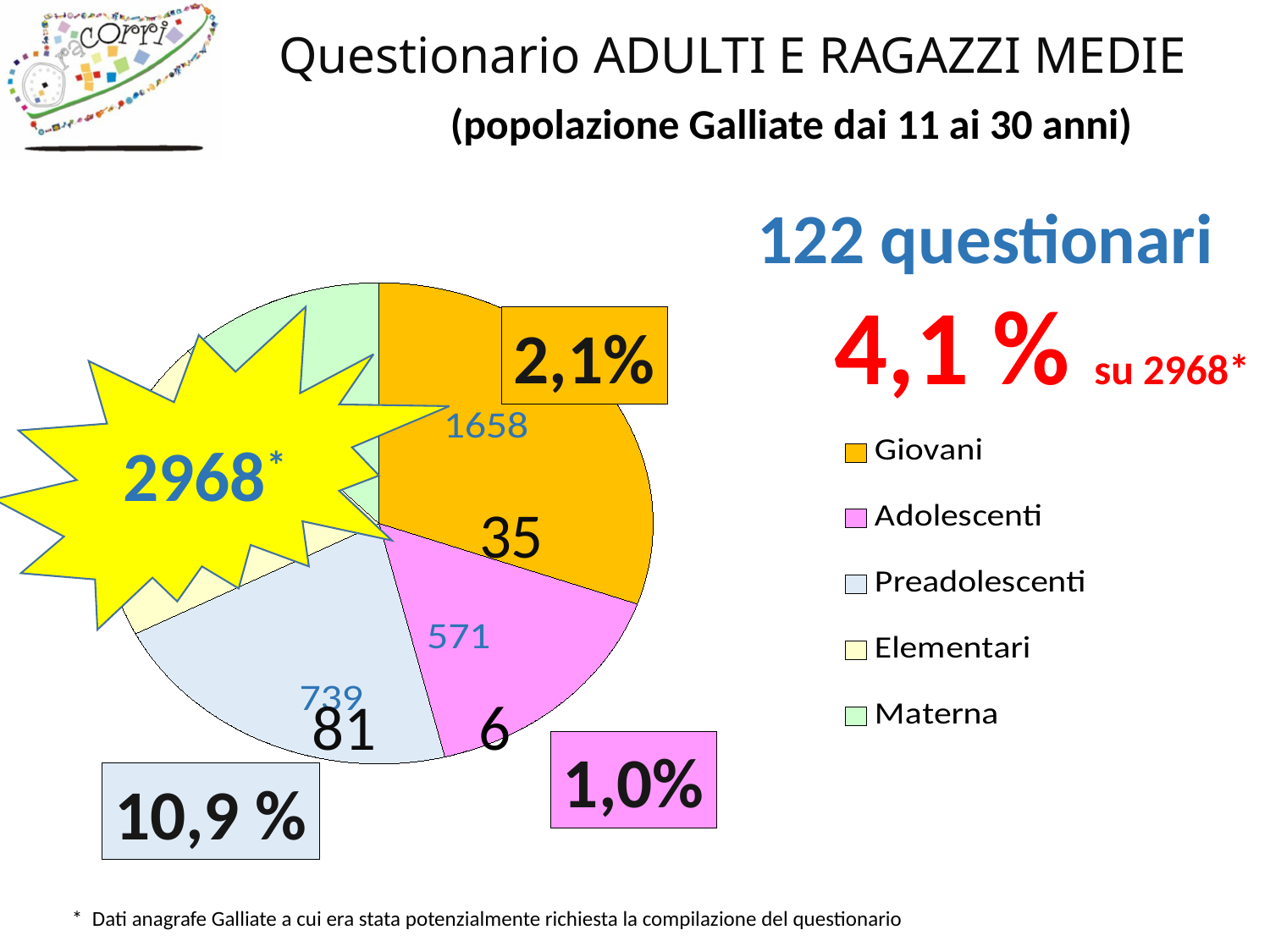
What percentage is shown in the box next to the Preadolescenti slice of the pie chart? 10,9 % What is the difference between the Giovani value and the Adolescenti value in the pie chart? 1087 What is the value shown for the Giovani slice of the pie chart? 1658 What is the value shown for the Preadolescenti slice of the pie chart? 739 What colour is used for the Giovani category in the pie chart legend? orange Which is larger in the pie chart, Preadolescenti or Adolescenti? Preadolescenti Which category has the largest slice in the pie chart? Giovani Which is larger in the pie chart, Giovani or Adolescenti? Giovani How many categories does the legend of the pie chart list? 5 What is the value shown for the Adolescenti slice of the pie chart? 571 What is the difference between the Preadolescenti value and the Adolescenti value in the pie chart? 168 What kind of chart is shown on the slide? pie chart